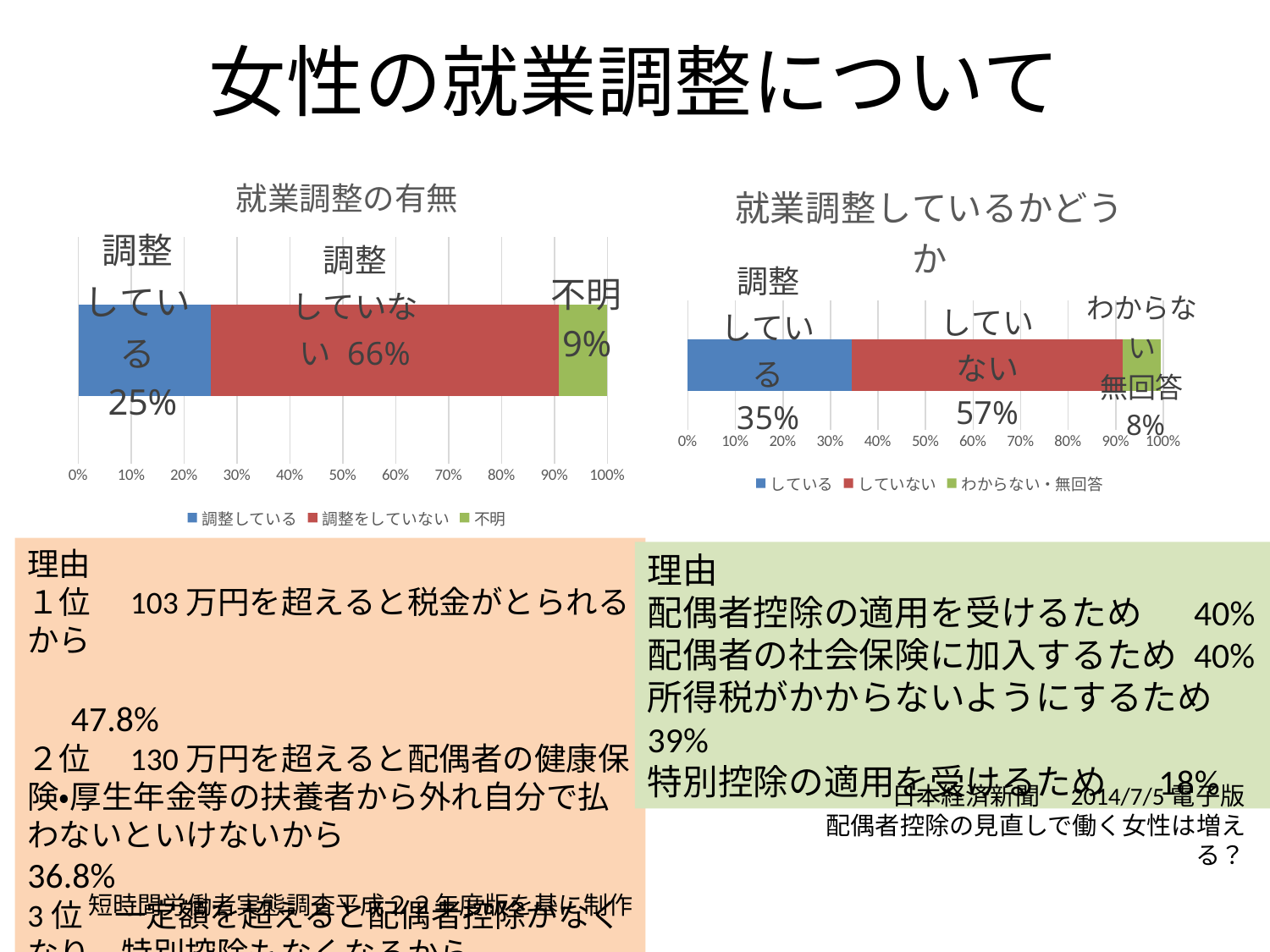
In the chart titled 就業調整の有無, what is the difference between the values for 調整していない and 調整している? 41% In the chart titled 就業調整しているかどうか, what is the value for している? 35% In the chart titled 就業調整の有無, what is the value for 不明? 9% In the chart titled 就業調整しているかどうか, what is the value for わからない・無回答? 8% In the chart titled 就業調整の有無, which segment has the largest value? 調整していない What kind of chart is the chart titled 就業調整の有無? Stacked bar chart In the chart titled 就業調整の有無, what is the value for 調整している? 25% In the chart titled 就業調整しているかどうか, which is larger: している or していない? していない How many series does the legend of the chart titled 就業調整しているかどうか list? 3 In the chart titled 就業調整しているかどうか, what is the value for していない? 57% In the chart titled 就業調整しているかどうか, which segment has the smallest value? わからない・無回答 In the chart titled 就業調整の有無, what is the value for 調整していない? 66%